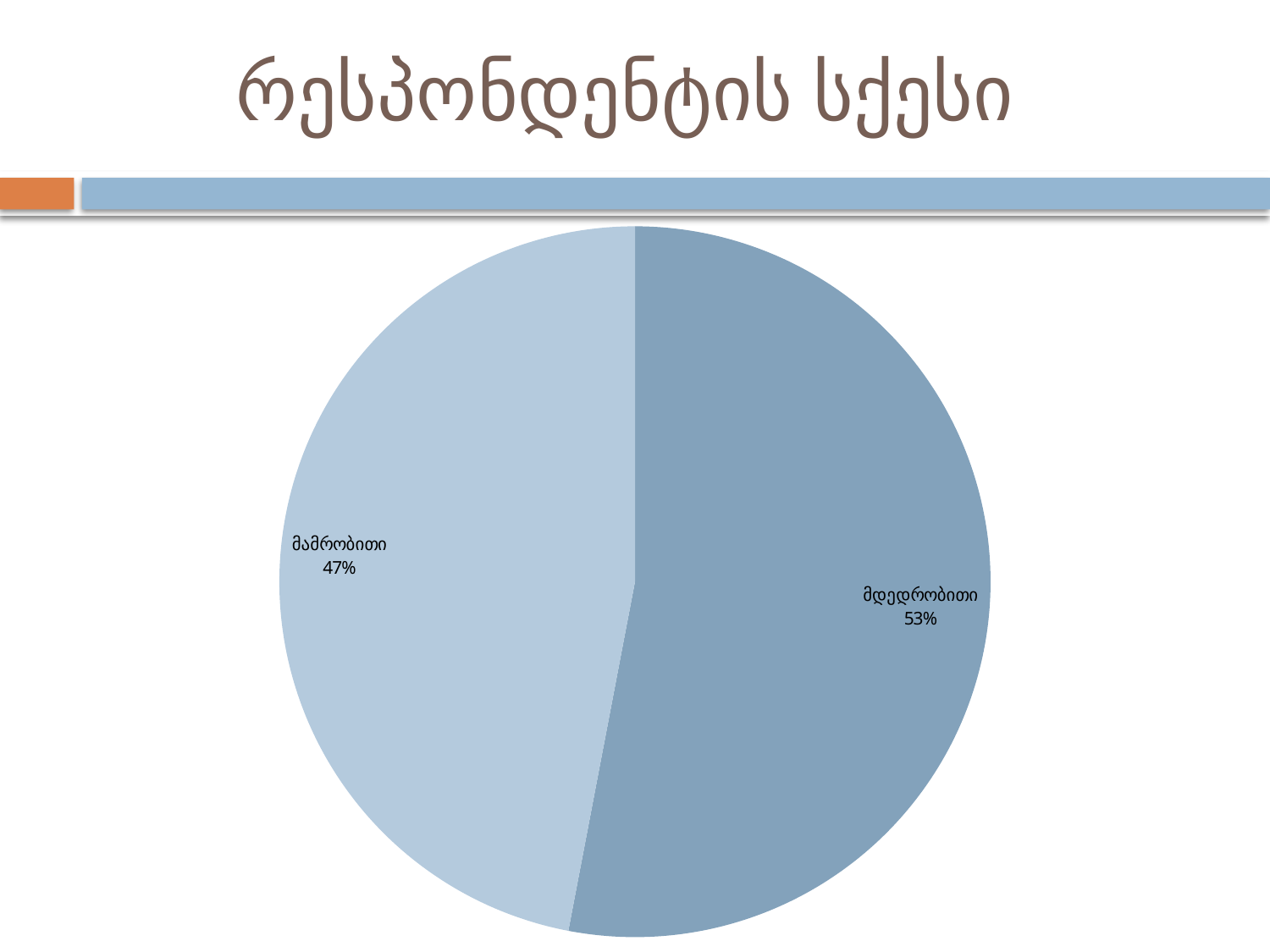
What kind of chart is shown on the slide? pie chart How many slices does the pie chart have? 2 Is the share for მდედრობითი greater or less than 50%? greater Is the share for მამრობითი greater or less than 50%? less What is the difference in percentage points between მდედრობითი and მამრობითი? 6 What is the share for მამრობითი in the pie chart? 47% Which slice of the pie chart is the smallest? მამრობითი Which slice of the pie chart is shown in the darker blue colour? მდედრობითი Which is larger, the share for მამრობითი or the share for მდედრობითი? მდედრობითი Which slice of the pie chart is the largest? მდედრობითი What is the title of the slide containing the pie chart? რესპონდენტის სქესი What is the share for მდედრობითი in the pie chart? 53%